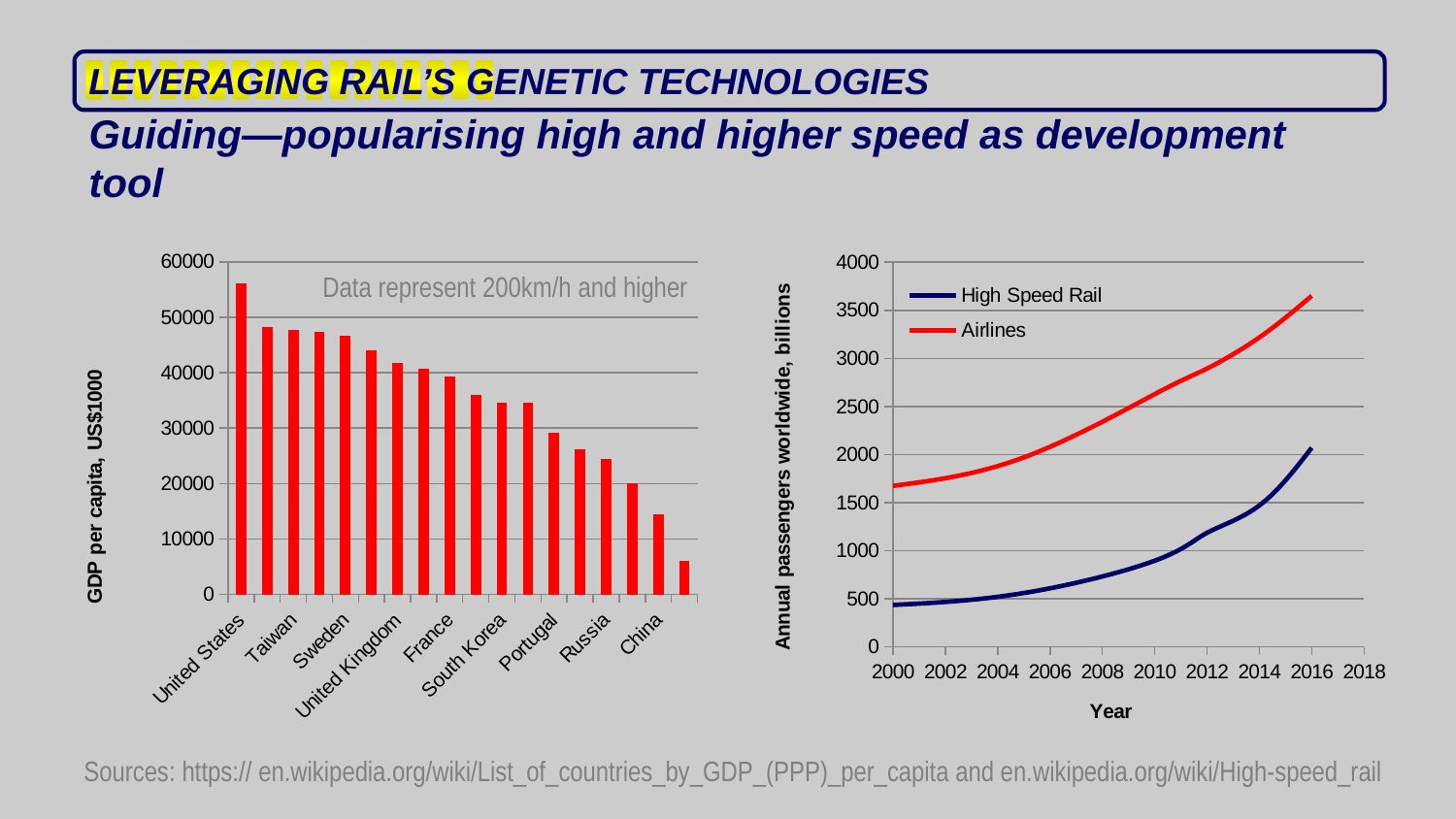
In the left GDP per capita chart, is the value for United States greater or less than 50000? greater In the left GDP per capita chart, which is larger, the value for Sweden or the value for Russia? Sweden In the left GDP per capita chart, is the value for Russia greater or less than 30000? less In the left GDP per capita chart, do the bars rise or fall from left to right? fall In the right chart, which series is higher in 2016, High Speed Rail or Airlines? Airlines In the left GDP per capita chart, which country has the highest bar? United States In the right chart, how many series does the legend list? 2 What kind of chart is the left chart showing GDP per capita? bar chart In the right chart, is the Airlines value in 2000 greater or less than 1500? greater What kind of chart is the right chart showing annual passengers worldwide? line chart In the right chart, what is the label on the vertical axis? Annual passengers worldwide, billions